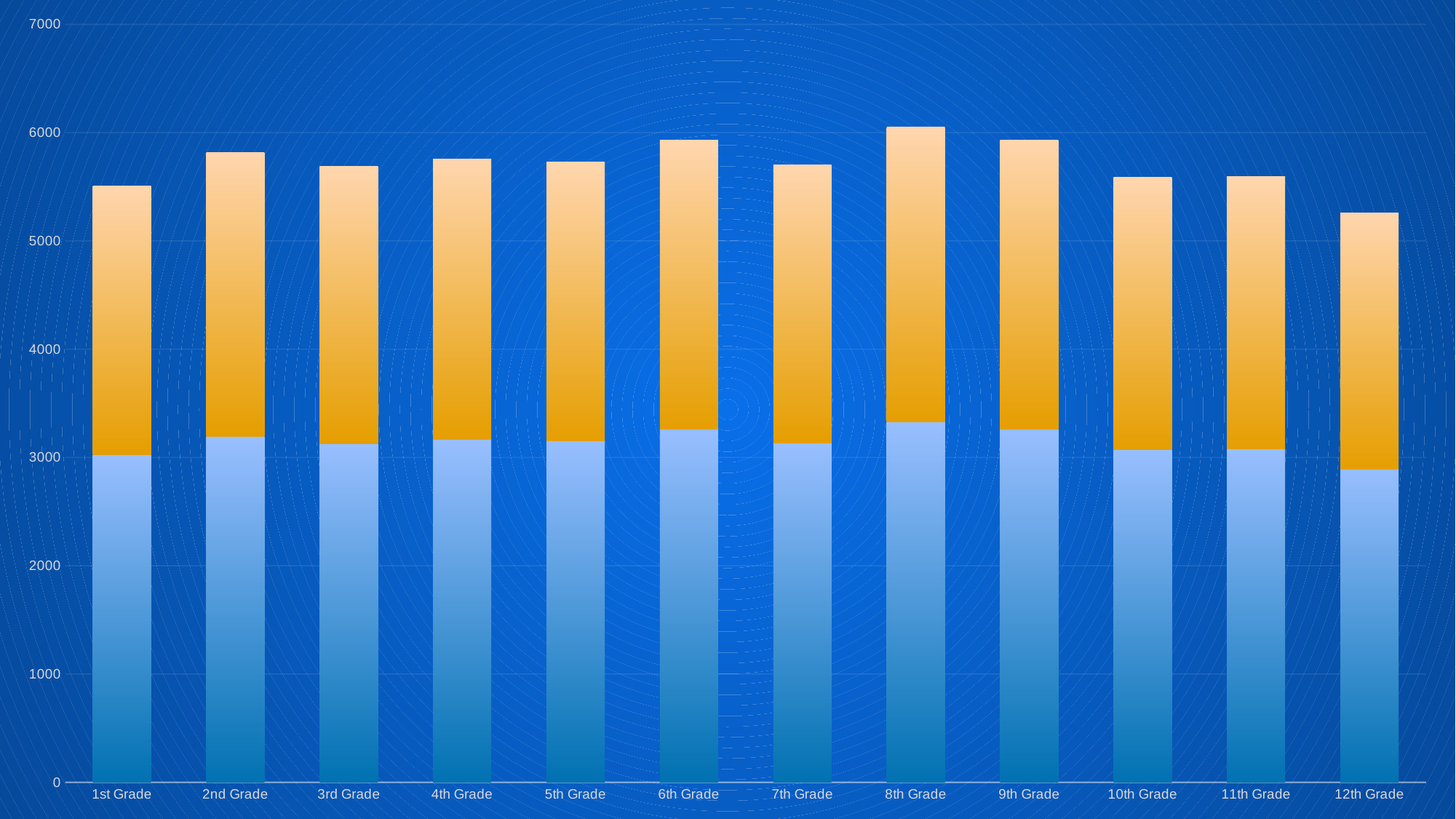
How many grade categories are shown on the x axis? 12 Is the blue segment for 12th Grade greater or less than 3000? less Which has the taller total bar, 1st Grade or 2nd Grade? 2nd Grade Which grade has the shortest stacked bar overall? 12th Grade Is the total bar height for 12th Grade greater or less than 6000? less Is the blue segment for 8th Grade greater or less than 3000? greater Which grade has the smallest blue segment? 12th Grade What is the highest value shown on the y axis? 7000 Which has the taller total bar, 1st Grade or 12th Grade? 1st Grade Which grade has the tallest stacked bar overall? 8th Grade What kind of chart is shown on the slide? Stacked bar chart